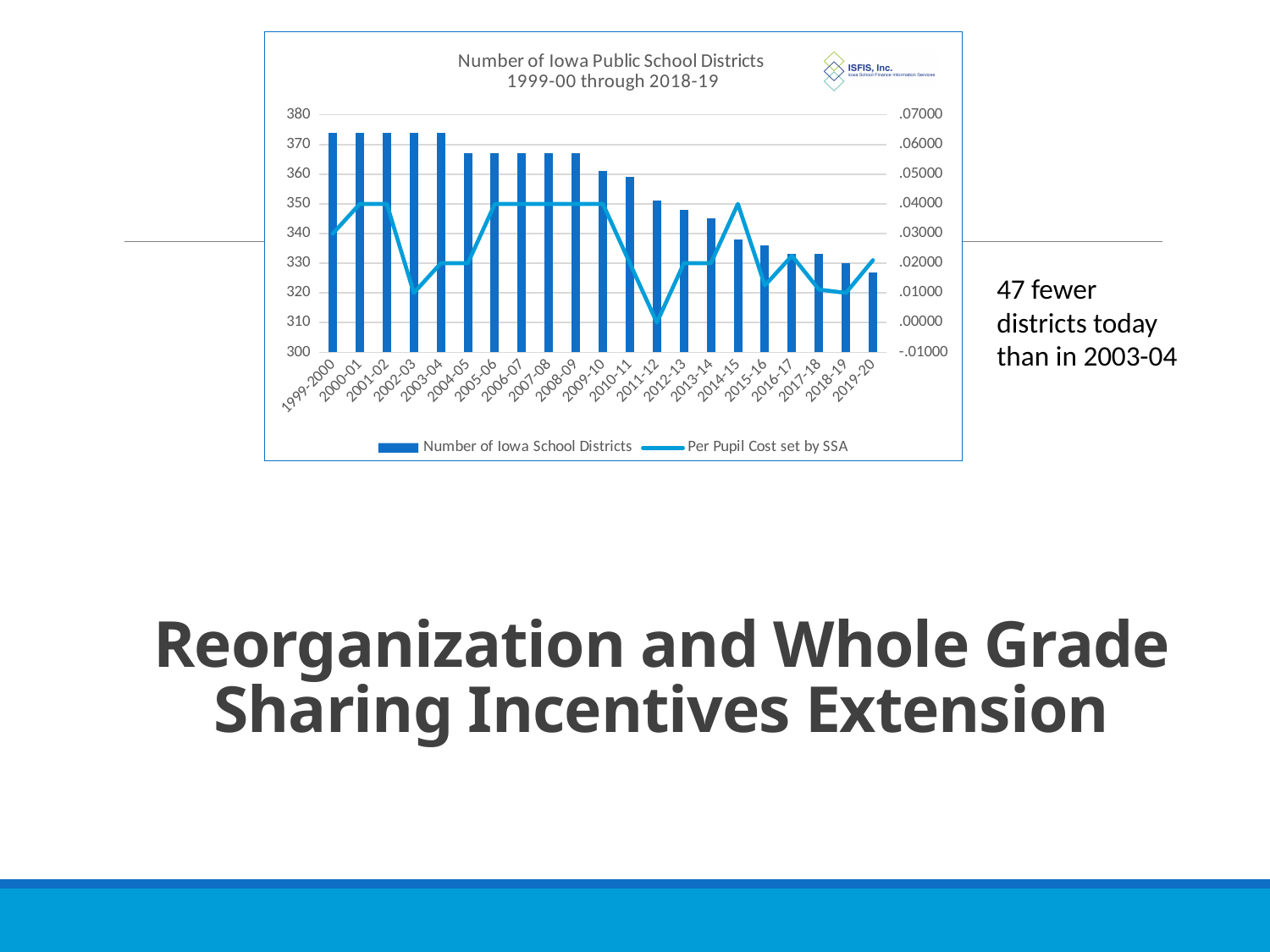
How many series does the legend list? 2 What is the title of the chart? Number of Iowa Public School Districts 1999-00 through 2018-19 Is the Per Pupil Cost set by SSA for 2011-12 greater or less than .01000? less Is the Number of Iowa School Districts for 2009-10 greater or less than 350? greater Is the Per Pupil Cost set by SSA for 2014-15 greater or less than .03000? greater How many school years are shown on the x axis? 21 Which is larger, the Number of Iowa School Districts in 2004-05 or in 2014-15? 2004-05 Which school year has the lowest Per Pupil Cost set by SSA? 2011-12 What kind of chart is shown on the slide? A combination bar and line chart Do the bars for Number of Iowa School Districts generally rise or fall from 1999-2000 to 2019-20? Fall